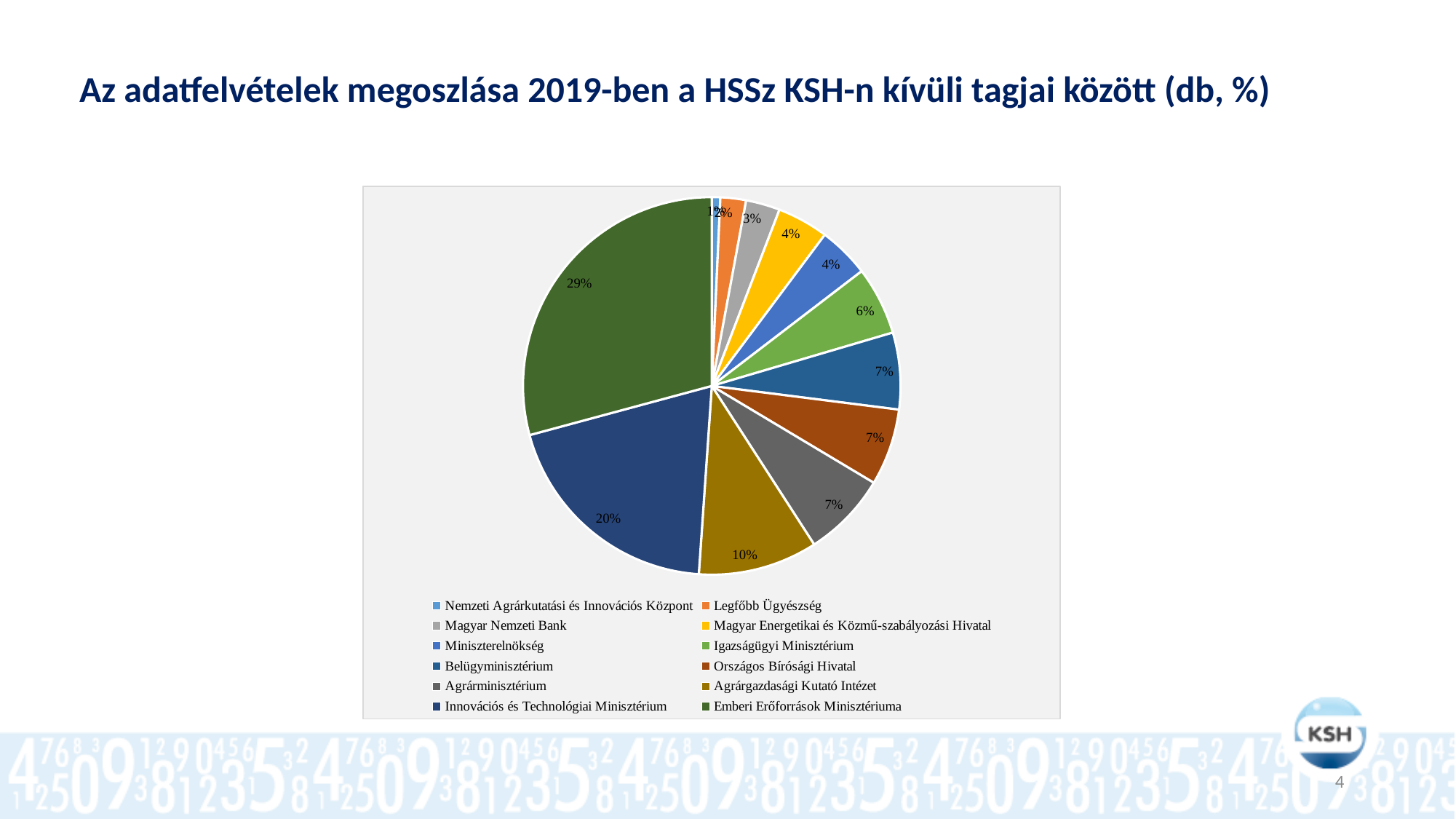
Which category has the smallest slice of the pie? Nemzeti Agrárkutatási és Innovációs Központ Which is larger, the share of Agrárgazdasági Kutató Intézet or the share of Belügyminisztérium? Agrárgazdasági Kutató Intézet What share of the pie does Emberi Erőforrások Minisztériuma have? 29% What is the value shown for Agrárgazdasági Kutató Intézet? 10% Which category has the largest slice of the pie? Emberi Erőforrások Minisztériuma What is the value shown for Magyar Nemzeti Bank? 3% What type of chart is shown on the slide? pie chart What is the value shown for Igazságügyi Minisztérium? 6% What is the difference between the shares of Emberi Erőforrások Minisztériuma and Innovációs és Technológiai Minisztérium? 9 percentage points What share of the pie does Innovációs és Technológiai Minisztérium have? 20% What is the title of the slide containing the chart? Az adatfelvételek megoszlása 2019-ben a HSSz KSH-n kívüli tagjai között (db, %) How many categories does the legend list? 12